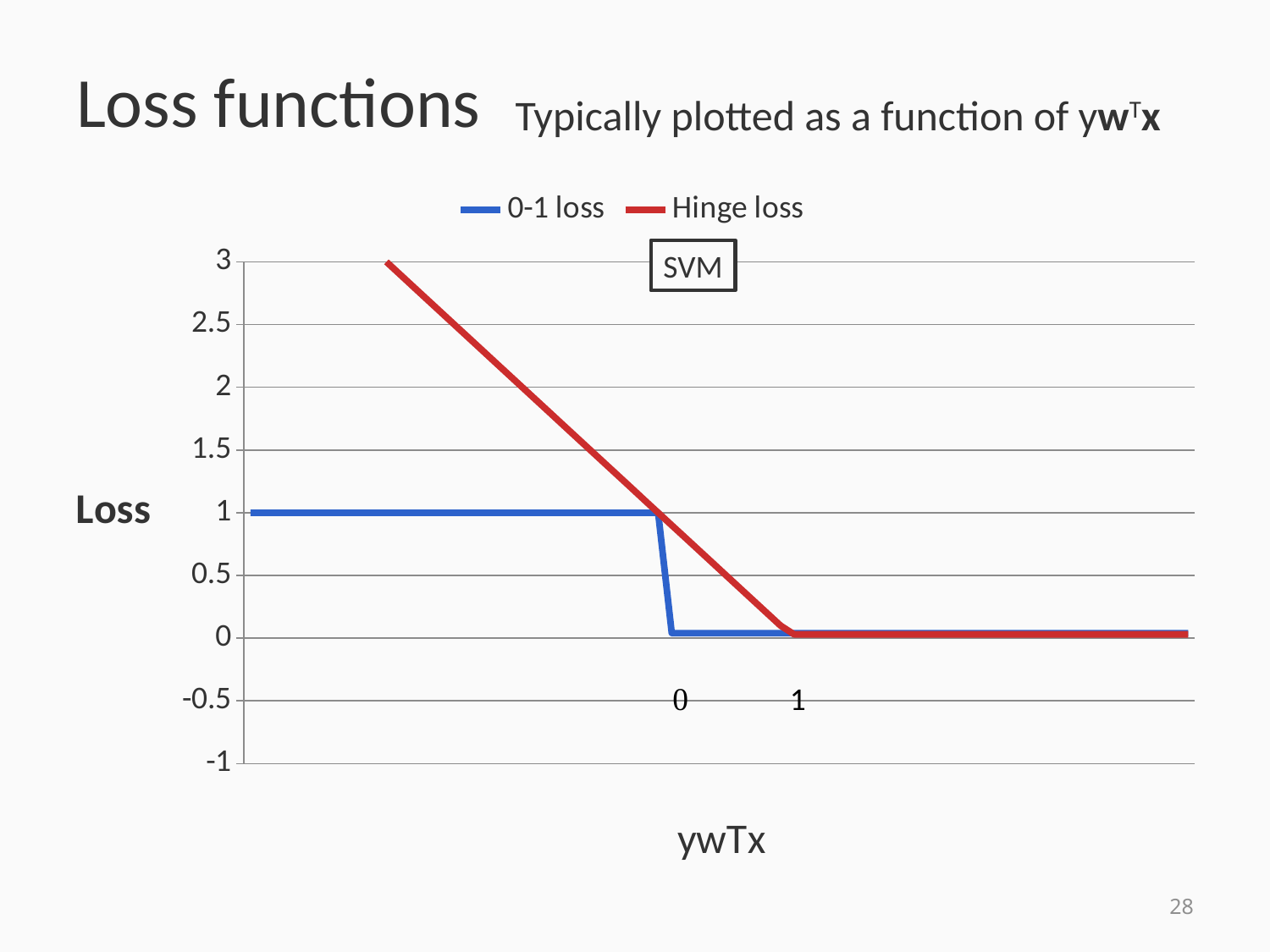
What are the two series named in the legend? 0-1 loss and Hinge loss What is the value of the 0-1 loss for ywTx values less than 0? 1 What kind of chart is shown on the slide? line chart Does the Hinge loss rise or fall as ywTx increases from the left edge of the chart to 1? fall What is the highest value shown on the vertical axis? 3 Is the Hinge loss at the left edge of the chart greater or less than 2? greater What is the value of the Hinge loss at ywTx = 0? 1 What is the label on the vertical axis of the chart? Loss How many series does the legend list? 2 Between ywTx = 0 and ywTx = 1, which series has the larger value, 0-1 loss or Hinge loss? Hinge loss